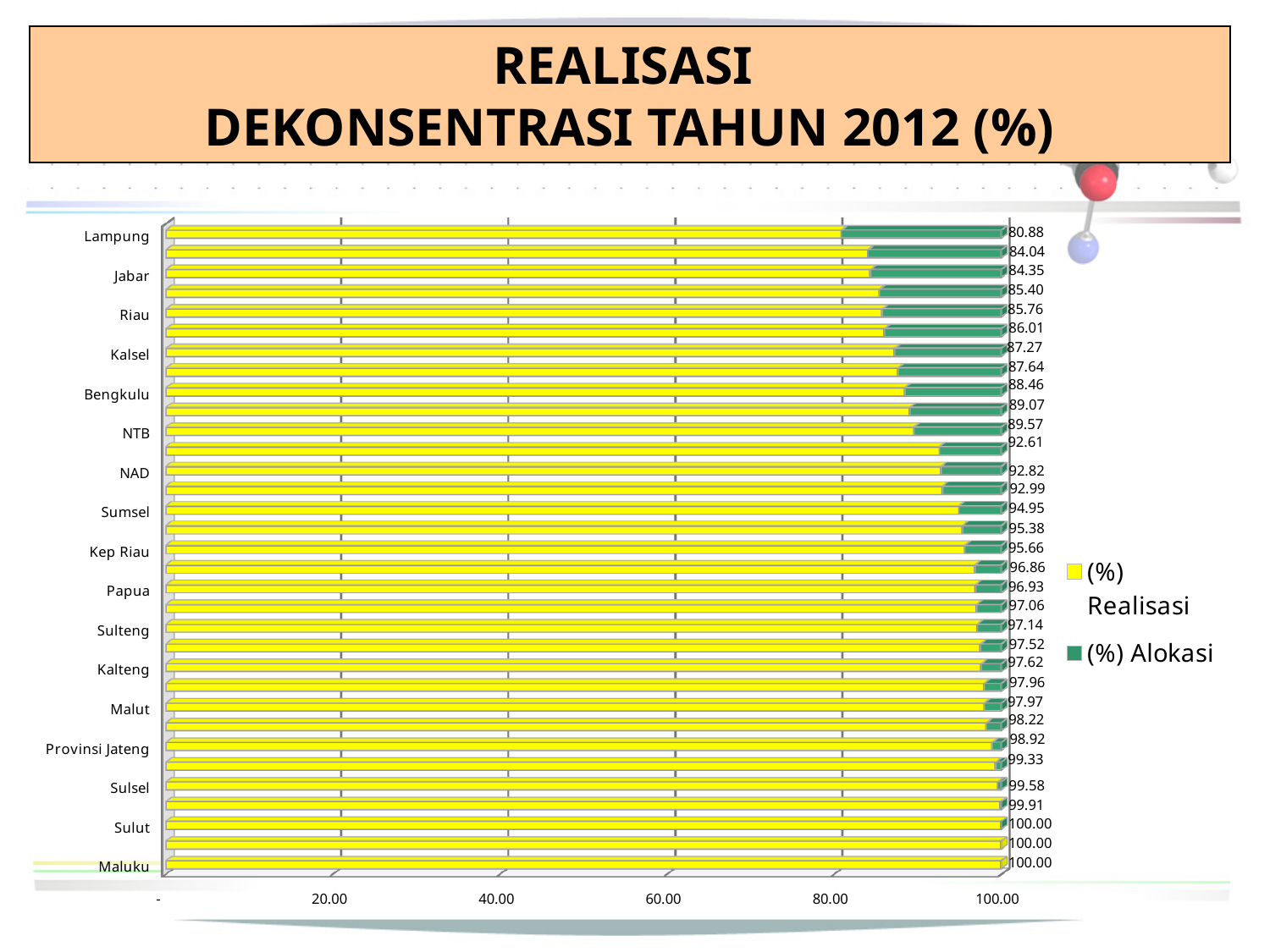
Which colour represents (%) Alokasi in the legend? green How many series does the legend list? 2 Which labelled province has the lowest value on the chart? Lampung Do the labelled values increase or decrease going down the chart from Lampung to Maluku? increase What is the difference between the labelled values for Jabar and Lampung? 3.47 What value is labelled for Sulsel? 99.58 Is the yellow (%) Realisasi bar for NTB greater or less than 80.00? greater What value is labelled for NAD? 92.82 Which has the larger labelled value, Riau or Kalsel? Kalsel What kind of chart is shown on the slide? bar chart What value is labelled for Lampung? 80.88 What value is labelled for Maluku? 100.00